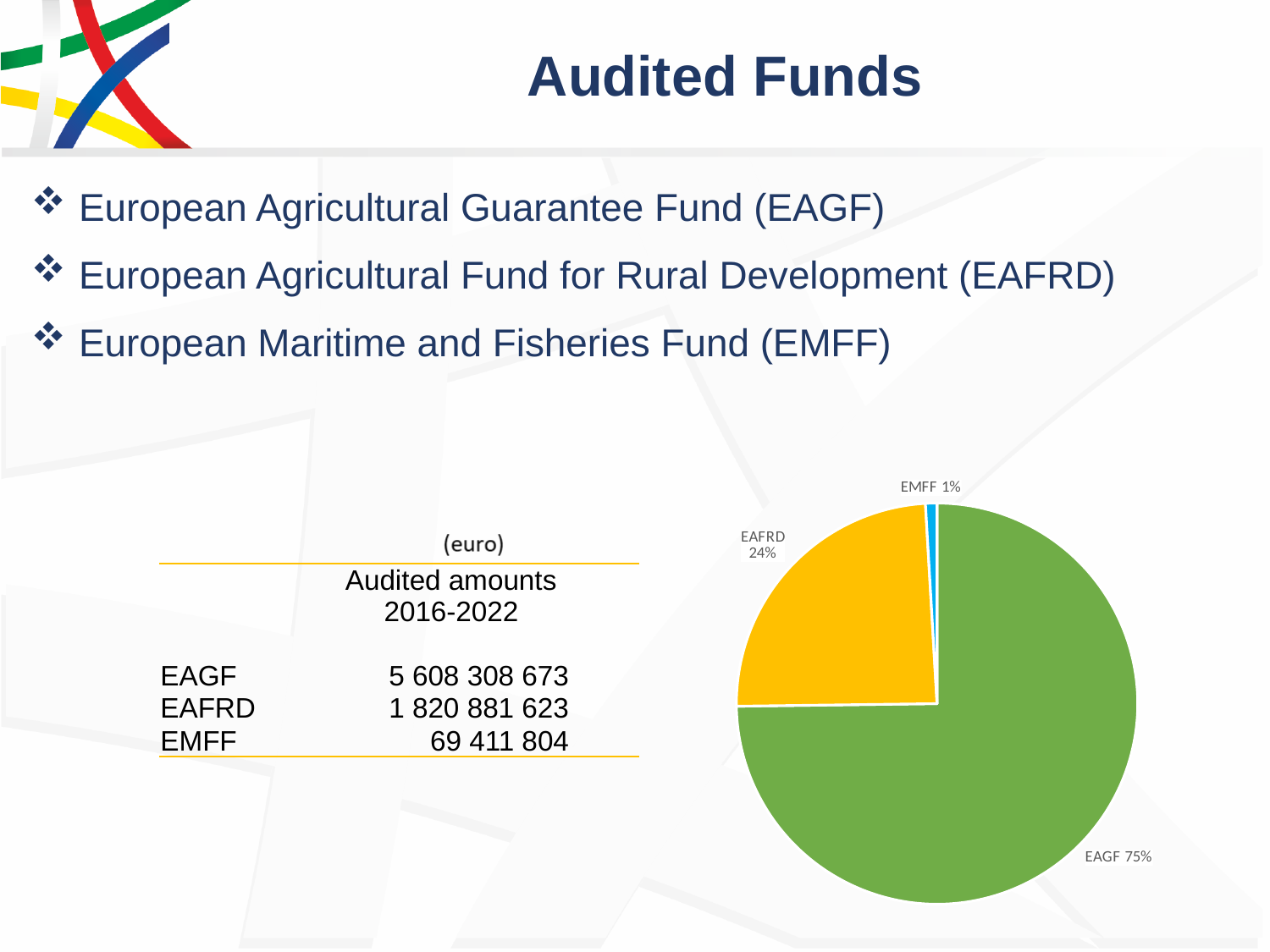
What share of the pie chart does EAFRD represent? 24% What share of the pie chart does EAGF represent? 75% What colour is the EAFRD slice in the pie chart? yellow What colour is the EAGF slice in the pie chart? green Which fund has the largest slice in the pie chart? EAGF Which slice is larger in the pie chart, EAFRD or EMFF? EAFRD Which fund has the smallest slice in the pie chart? EMFF How many slices does the pie chart have? 3 What is the difference in percentage points between the EAGF and EAFRD slices? 51 What kind of chart is shown on the slide? pie chart What share of the pie chart does EMFF represent? 1%